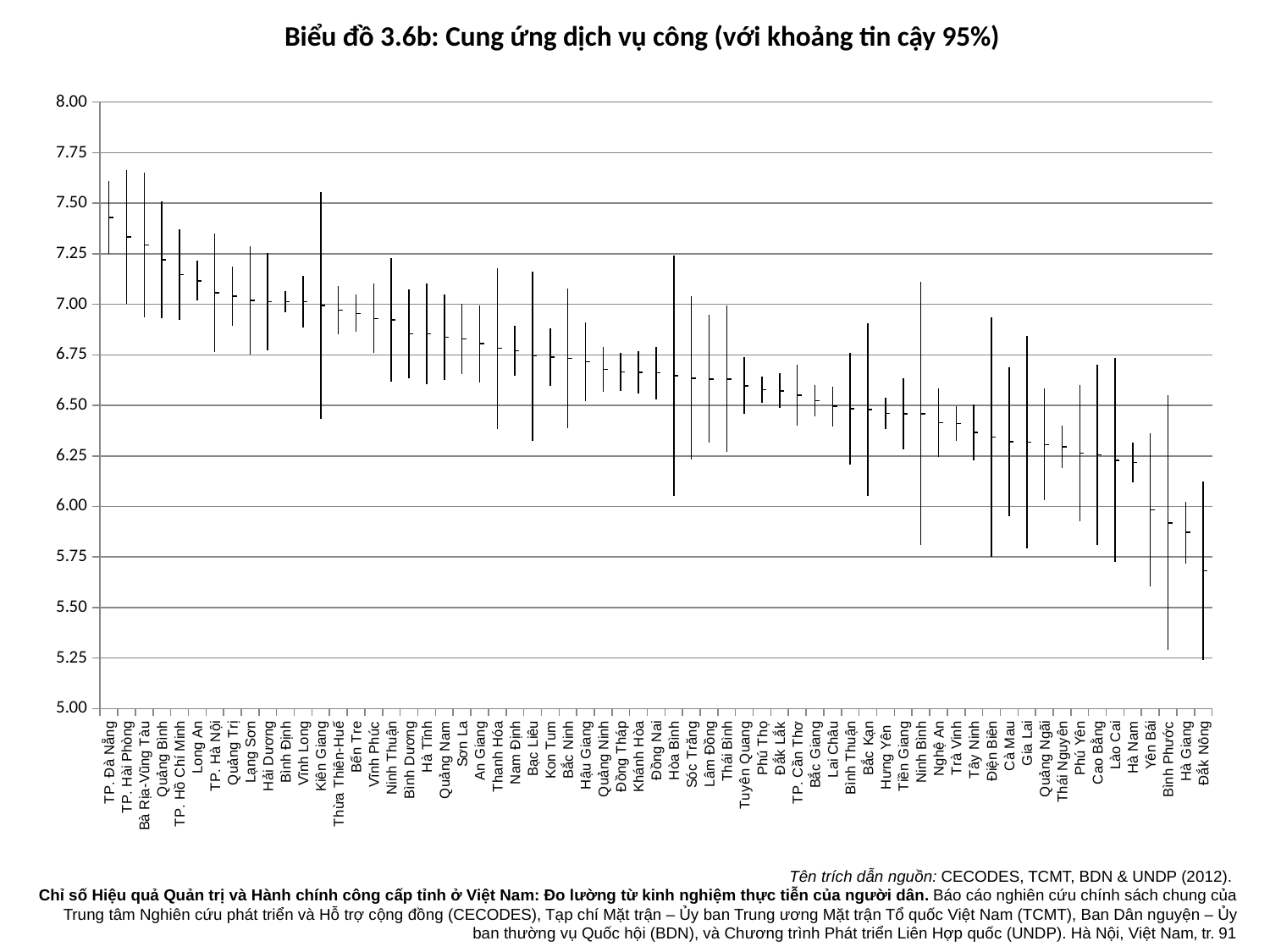
Is the point estimate for TP. Đà Nẵng greater or less than 7.25? greater What kind of chart is this? A high-low (error bar / confidence interval) chart Which province has the lowest point estimate? Đắk Nông Is the point estimate for Đắk Nông greater or less than 6.00? less Which has the larger point estimate, Quảng Bình or Hà Nam? Quảng Bình How many provinces/cities are plotted along the x axis? 63 Is the point estimate for Hòa Bình greater or less than 7.00? less Which province has the highest point estimate? TP. Đà Nẵng What is the title of the chart? Biểu đồ 3.6b: Cung ứng dịch vụ công (với khoảng tin cậy 95%) Do the point estimates rise or fall moving from left to right along the x axis? Fall What are the minimum and maximum values shown on the y axis? 5.00 and 8.00